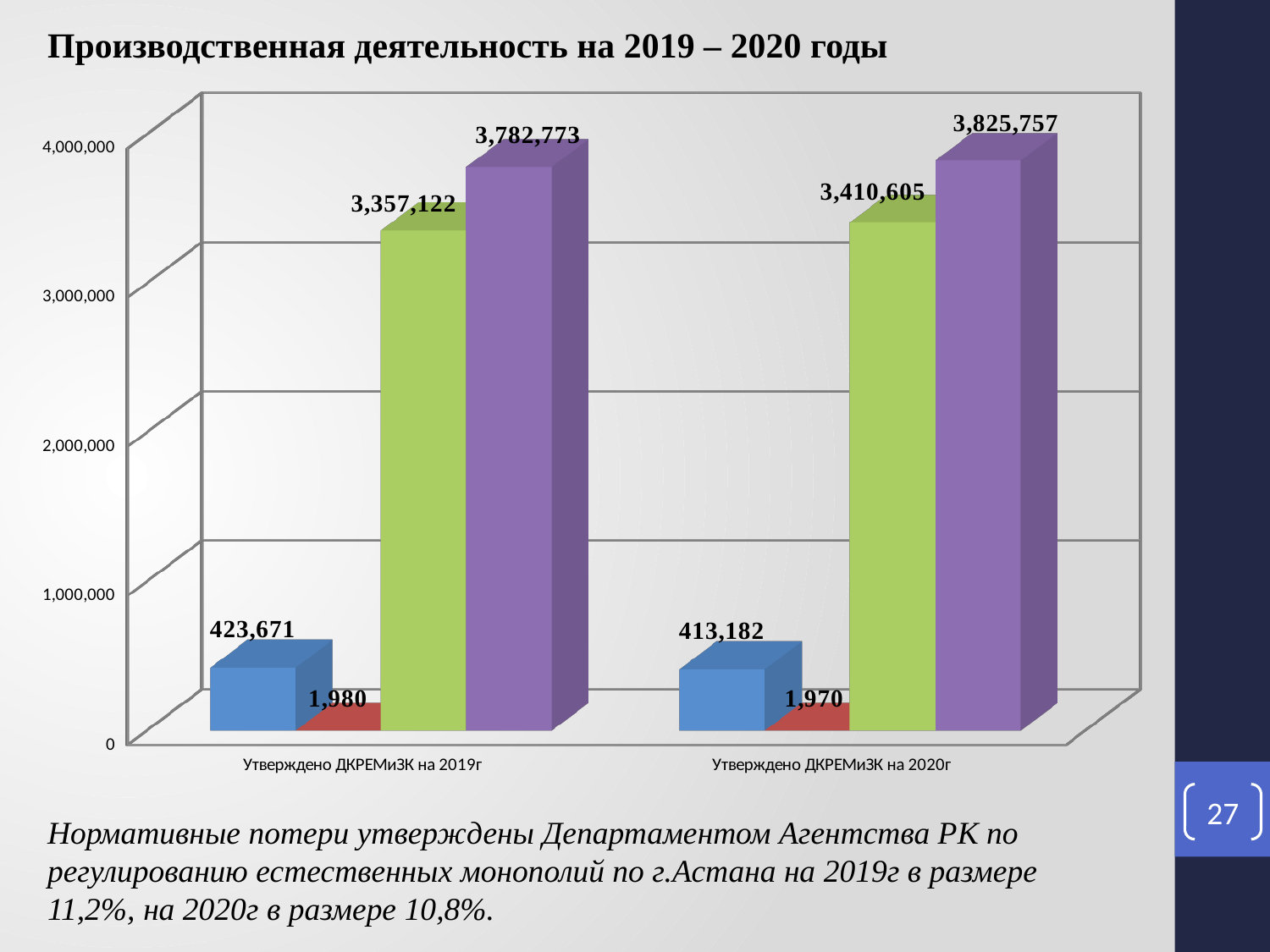
Which bar has the highest value in the chart? The purple bar for 'Утверждено ДКРЕМиЗК на 2020г' (3,825,757) What is the value of the purple bar for 'Утверждено ДКРЕМиЗК на 2019г'? 3,782,773 What is the difference between the green bar values for 2020 and 2019? 53,483 What is the value of the blue bar for 'Утверждено ДКРЕМиЗК на 2019г'? 423,671 What is the value of the red bar for 'Утверждено ДКРЕМиЗК на 2020г'? 1,970 How many categories are shown on the x axis of the chart? 2 What is the title of the slide containing the chart? Производственная деятельность на 2019 – 2020 годы What is the difference between the purple bar values for 2020 and 2019? 42,984 What is the value of the green bar for 'Утверждено ДКРЕМиЗК на 2020г'? 3,410,605 Which bar has the lowest value in the chart? The red bar for 'Утверждено ДКРЕМиЗК на 2020г' (1,970) What kind of chart is shown on the slide? Bar chart Is the blue bar value for 'Утверждено ДКРЕМиЗК на 2019г' larger or smaller than the blue bar value for 'Утверждено ДКРЕМиЗК на 2020г'? Larger